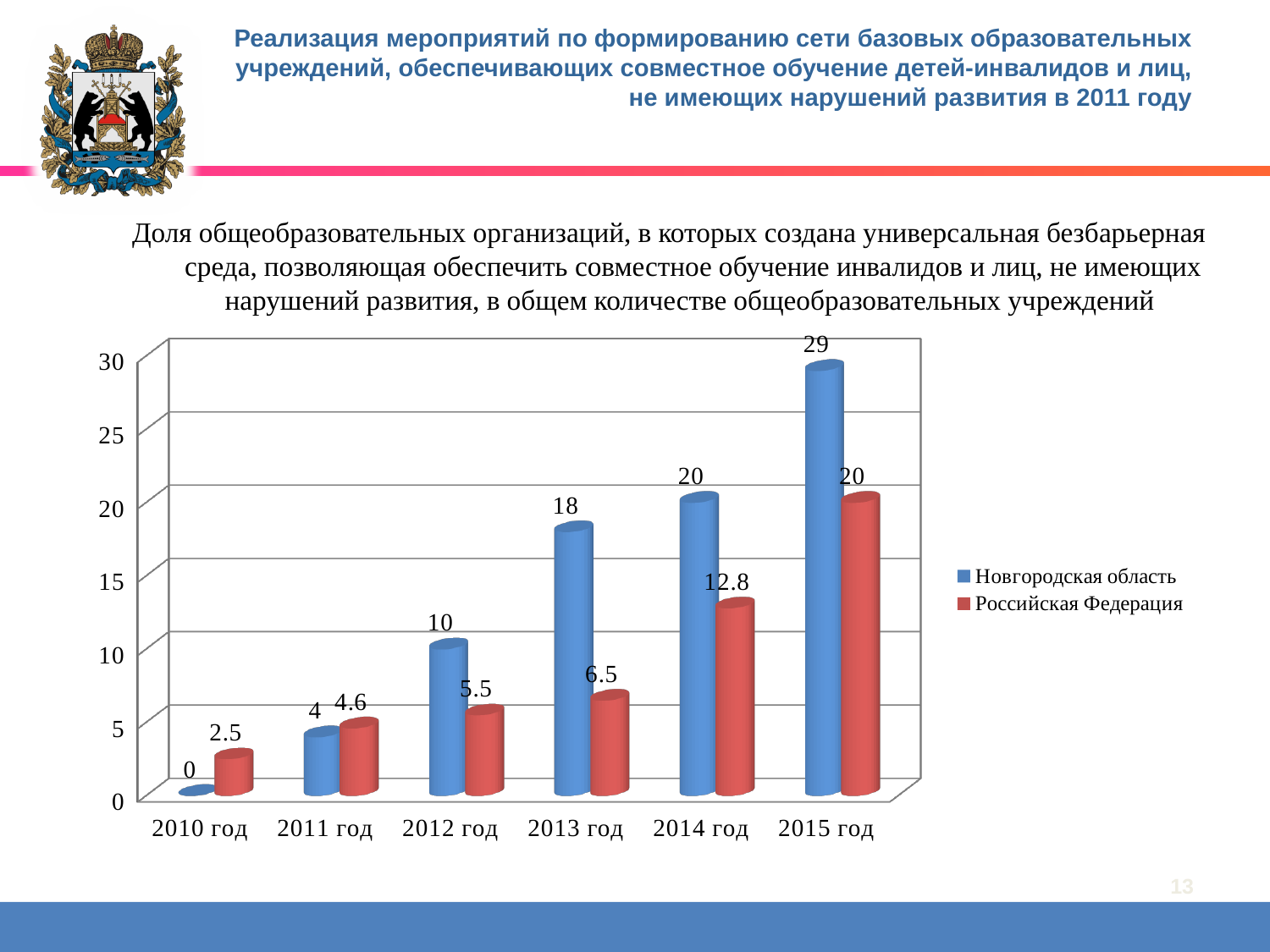
What is the difference between Новгородская область and Российская Федерация in 2013 год? 11.5 What is the value for Новгородская область in 2010 год? 0 Which year has the lowest value for Российская Федерация? 2010 год What kind of chart is shown on the slide? bar chart How many years are shown on the x axis? 6 What is the value for Новгородская область in 2015 год? 29 What is the value for Российская Федерация in 2014 год? 12.8 Which is larger in 2011 год: Новгородская область or Российская Федерация? Российская Федерация How many series does the legend list? 2 What is the value for Российская Федерация in 2012 год? 5.5 Do the values for Новгородская область rise or fall from 2010 год to 2015 год? rise Which year has the highest value for Новгородская область? 2015 год